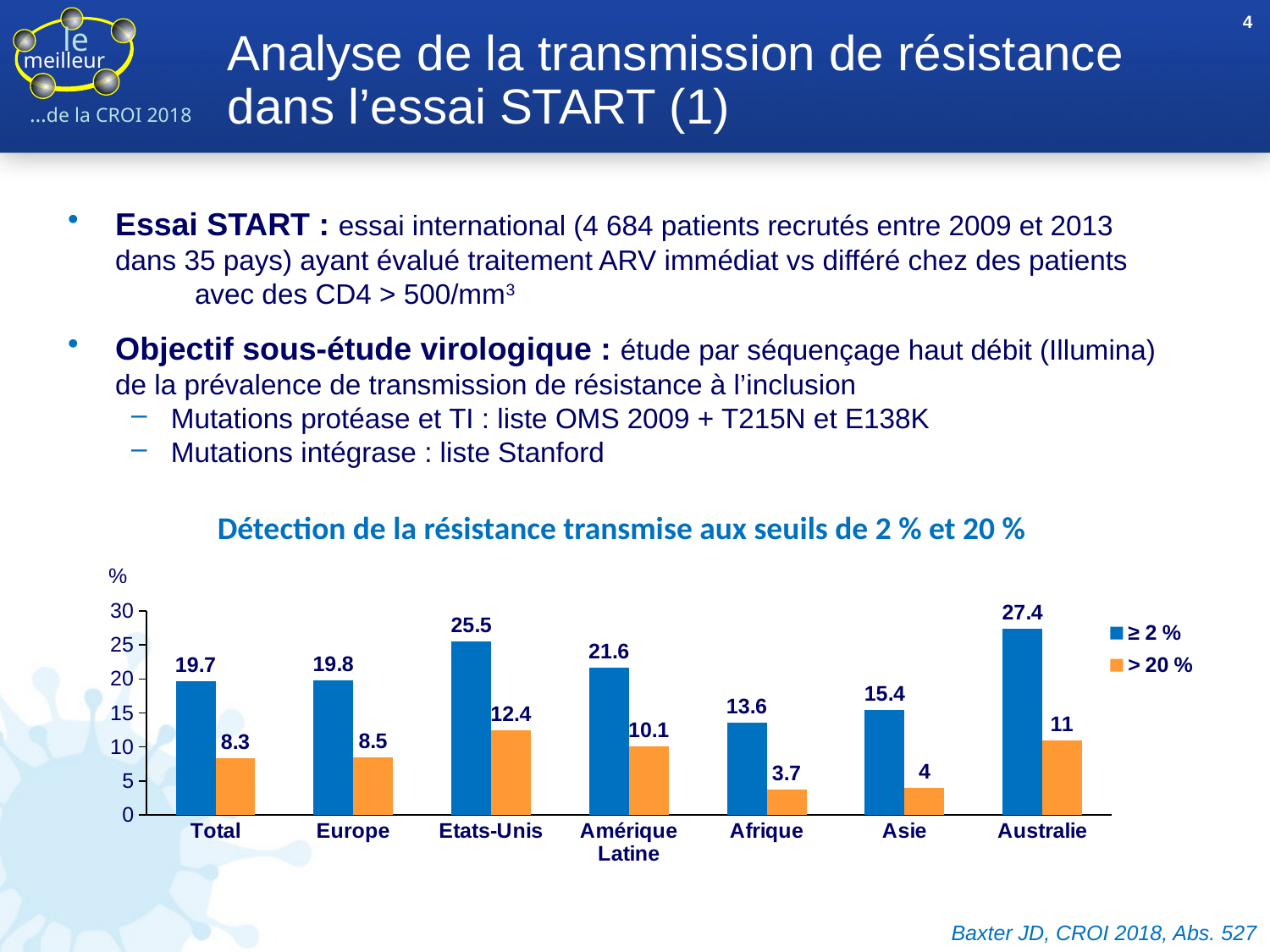
Which is larger, the ≥ 2 % value for Asie or the ≥ 2 % value for Afrique? Asie What is the difference between the ≥ 2 % and > 20 % values for Amérique Latine? 11.5 What is the title of the chart? Détection de la résistance transmise aux seuils de 2 % et 20 % What is the value of the > 20 % series for Afrique? 3.7 How many series does the legend list? 2 Which category has the highest value in the ≥ 2 % series? Australie What is the value of the ≥ 2 % series for Etats-Unis? 25.5 How many categories are shown on the x axis? 7 Is the ≥ 2 % value for Australie greater or less than 25? greater What is the value of the ≥ 2 % series for Total? 19.7 Which category has the lowest value in the > 20 % series? Afrique What kind of chart is shown on the slide? bar chart